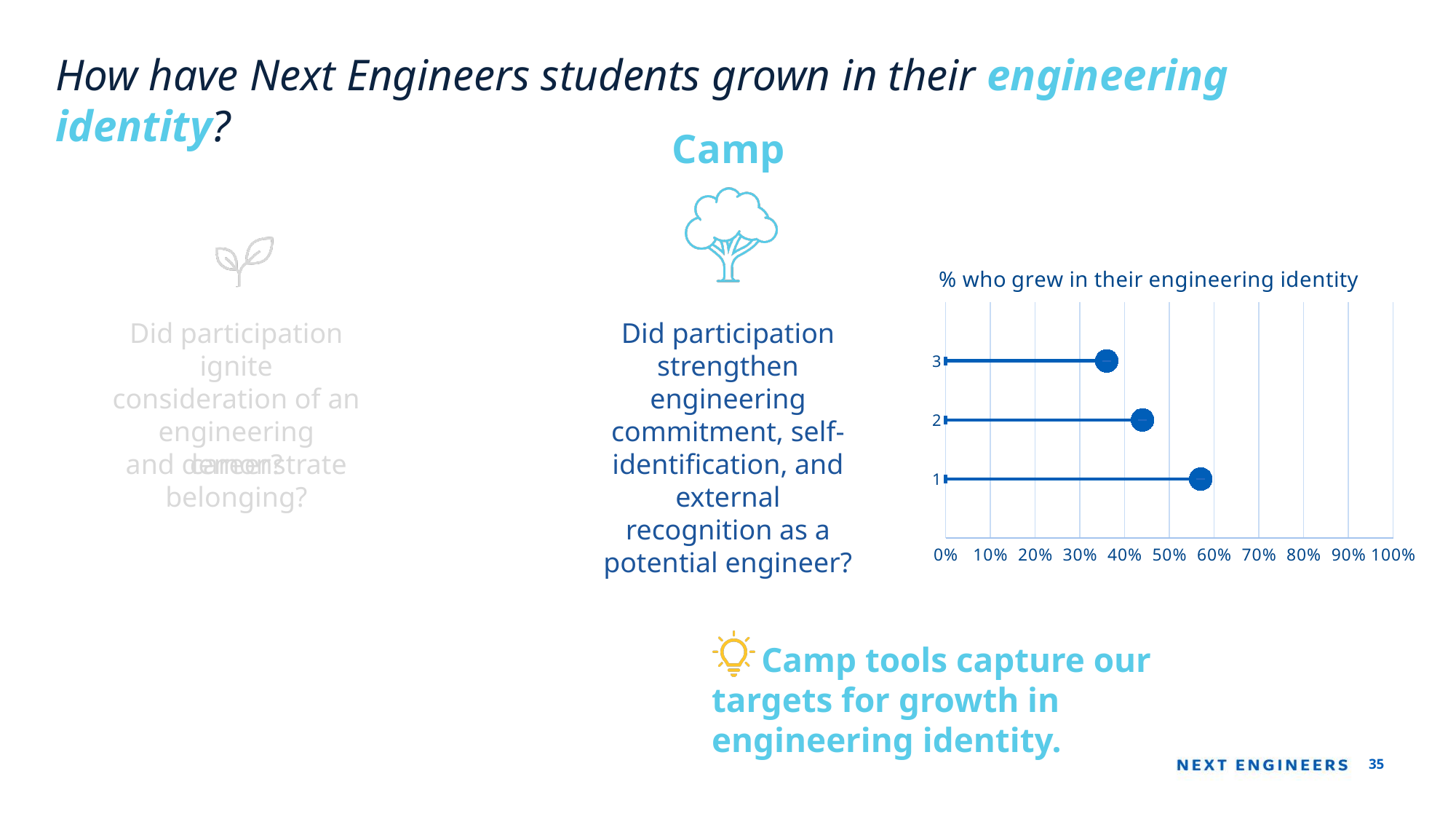
Which category has the highest value in the chart? 1 What is the maximum value shown on the chart's horizontal axis? 100% Is the value for category 2 greater or less than 50%? less Which has a larger value, category 2 or category 3? 2 Is the value for category 2 greater or less than 40%? greater What is the title of the chart on the slide? % who grew in their engineering identity Is the value for category 1 greater or less than 50%? greater What kind of chart is shown on the slide? bar chart Which category has the lowest value in the chart? 3 How many categories are plotted in the chart? 3 Which has a larger value, category 1 or category 3? 1